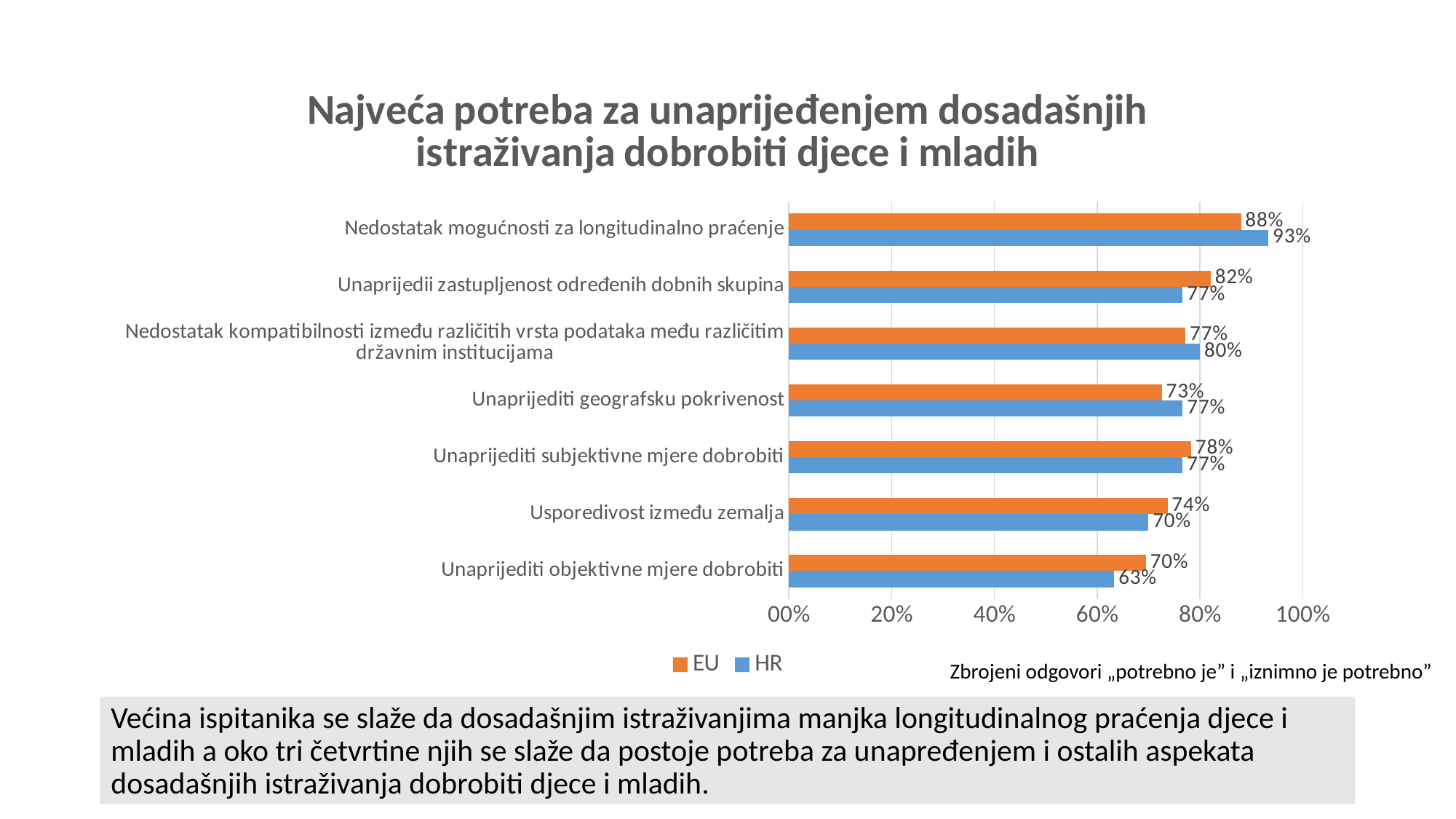
For "Unaprijedii zastupljenost određenih dobnih skupina", which is larger, the EU value or the HR value? EU How many categories are shown on the chart? 7 What is the EU value for "Usporedivost između zemalja"? 74% What is the difference between the HR and EU values for "Nedostatak mogućnosti za longitudinalno praćenje"? 5% What is the HR value for "Nedostatak mogućnosti za longitudinalno praćenje"? 93% What is the EU value for "Nedostatak mogućnosti za longitudinalno praćenje"? 88% What is the HR value for "Unaprijediti objektivne mjere dobrobiti"? 63% What is the difference between the EU and HR values for "Unaprijediti objektivne mjere dobrobiti"? 7% Which category has the highest HR value? Nedostatak mogućnosti za longitudinalno praćenje How many series does the legend list? 2 Which category has the lowest EU value? Unaprijediti objektivne mjere dobrobiti What kind of chart is shown on the slide? Bar chart